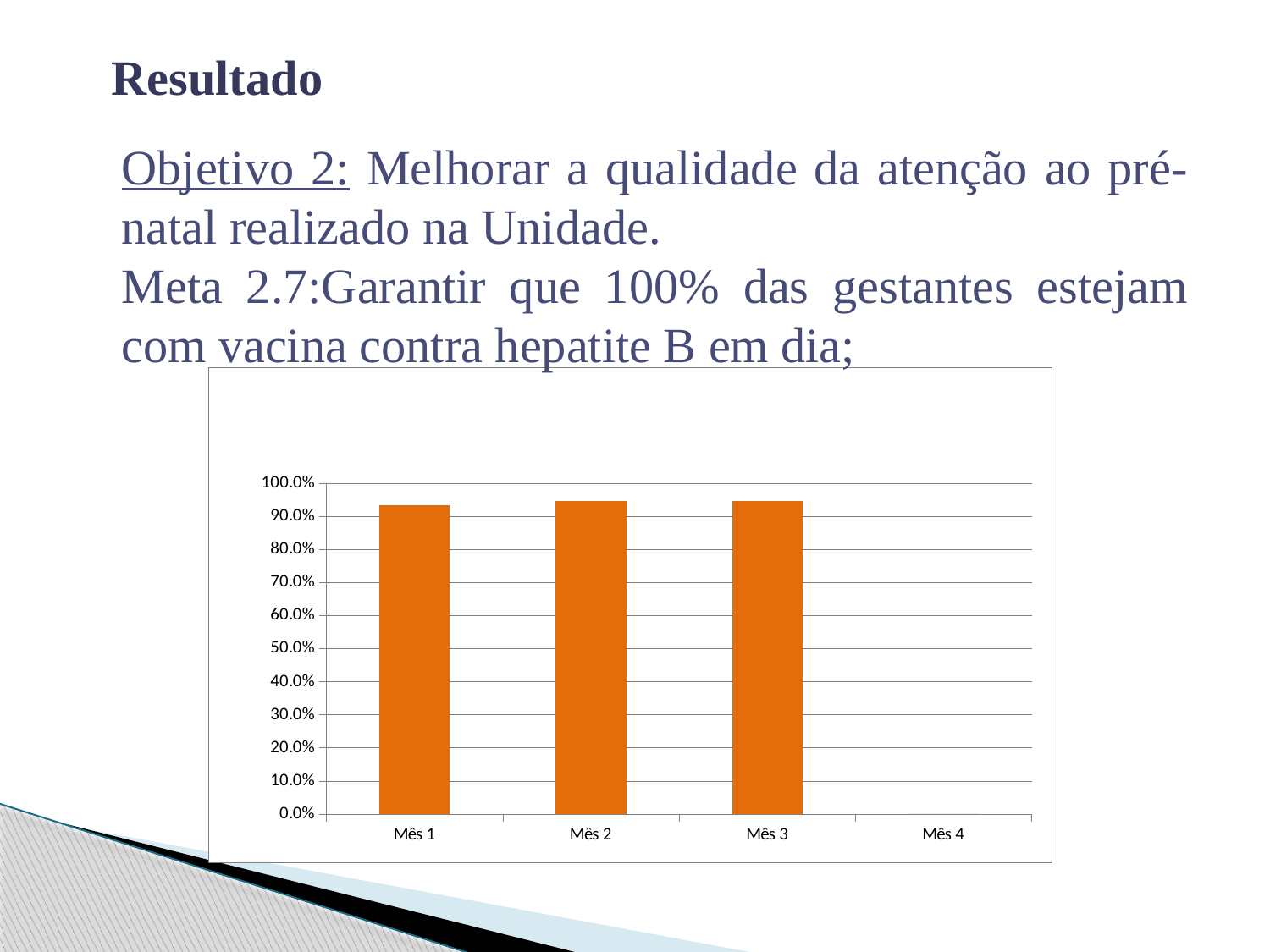
What is the highest value shown on the y axis of the chart? 100.0% Which category on the chart has no visible bar? Mês 4 Is the value for Mês 2 greater or less than 100.0%? less Is the value for Mês 3 greater or less than 90.0%? greater How many categories are shown on the x axis of the chart? 4 Is the value for Mês 1 greater or less than 90.0%? greater What kind of chart is shown on the slide? bar chart What colour are the bars in the chart? orange